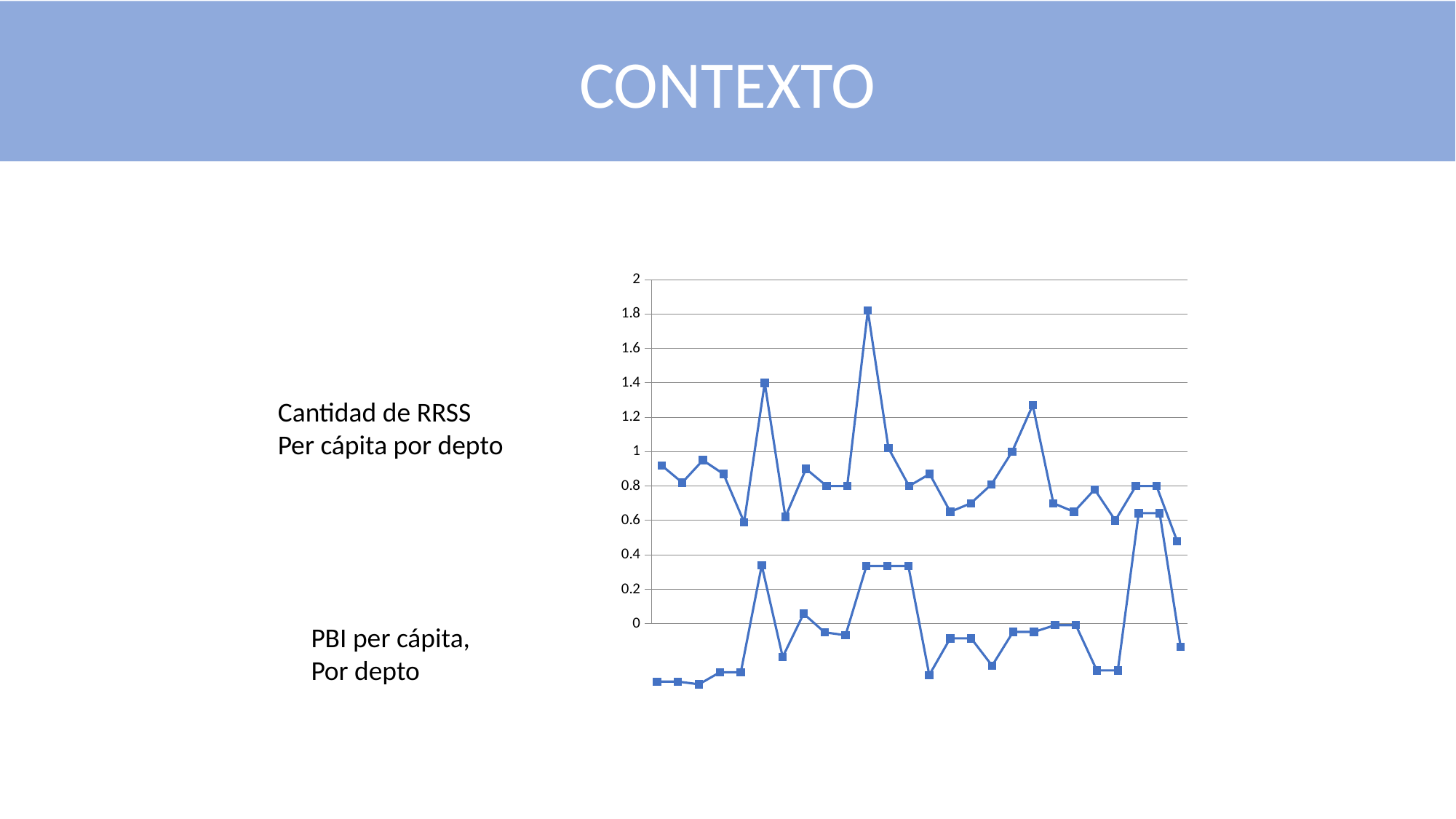
Is the last point of the upper line (Cantidad de RRSS) higher or lower than its first point? lower Is the highest point of the lower line (PBI per cápita) greater or less than 0.4? greater What is the highest value labelled on the vertical axis? 2 What is the interval between consecutive tick labels on the vertical axis? 0.2 How many lines are plotted on the chart? 2 What kind of chart is shown on the slide? line chart Is the highest point of the upper line (Cantidad de RRSS per cápita) greater or less than 1.6? greater Is the final point of the upper line (Cantidad de RRSS per cápita) greater or less than 0.6? less